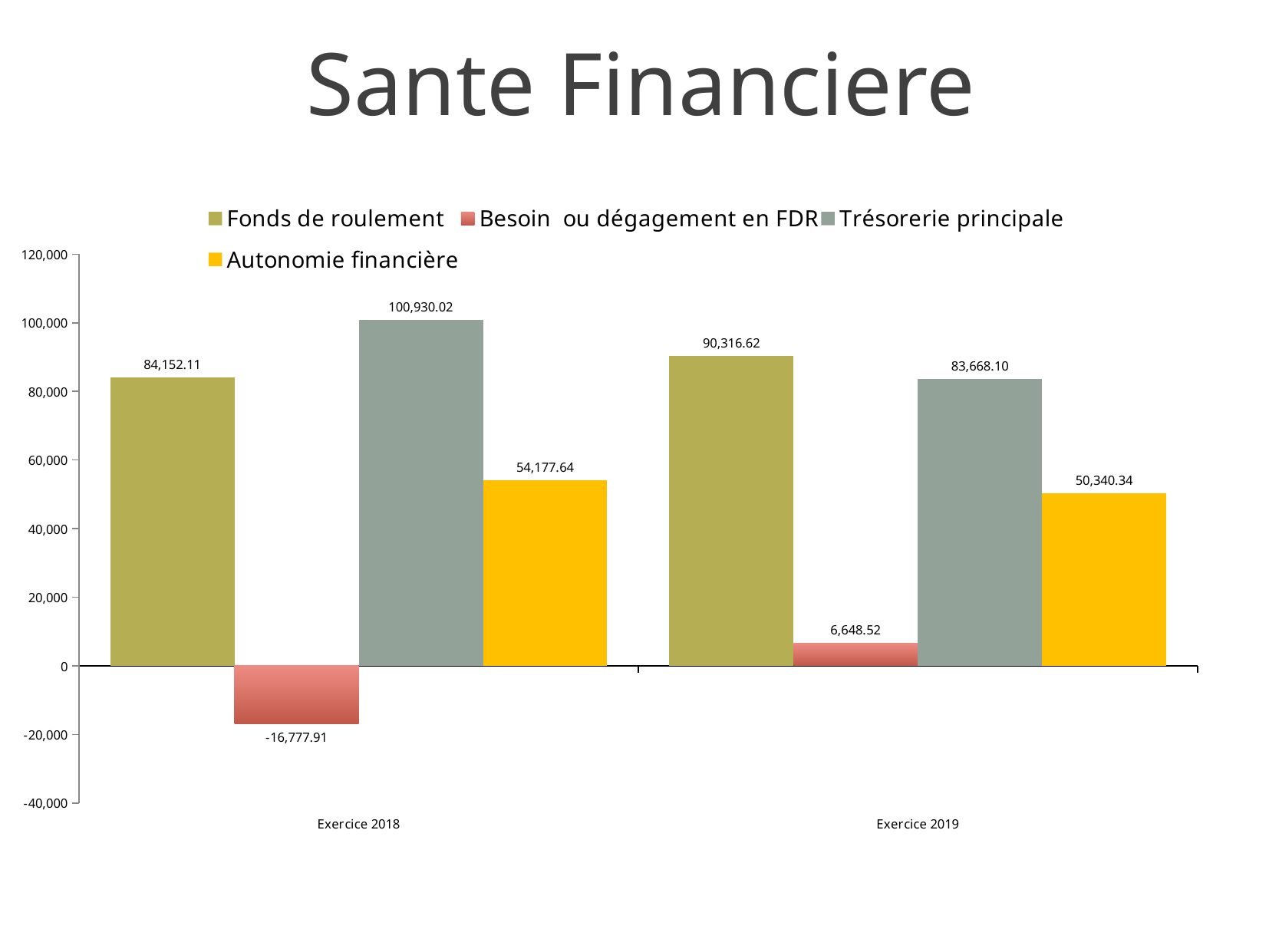
What is the value of Besoin ou dégagement en FDR for Exercice 2018? -16,777.91 What is the value of Trésorerie principale for Exercice 2019? 83,668.10 Which series has the highest value for Exercice 2018? Trésorerie principale How many categories are shown on the x axis? 2 Which is larger: Fonds de roulement for Exercice 2018 or for Exercice 2019? Exercice 2019 Does Fonds de roulement rise or fall from Exercice 2018 to Exercice 2019? rise What is the difference between Trésorerie principale for Exercice 2018 and Exercice 2019? 17,261.92 Which series has the lowest value for Exercice 2019? Besoin ou dégagement en FDR What is the value of Fonds de roulement for Exercice 2018? 84,152.11 What is the value of Autonomie financière for Exercice 2019? 50,340.34 How many series does the legend list? 4 What type of chart is shown on the slide? bar chart